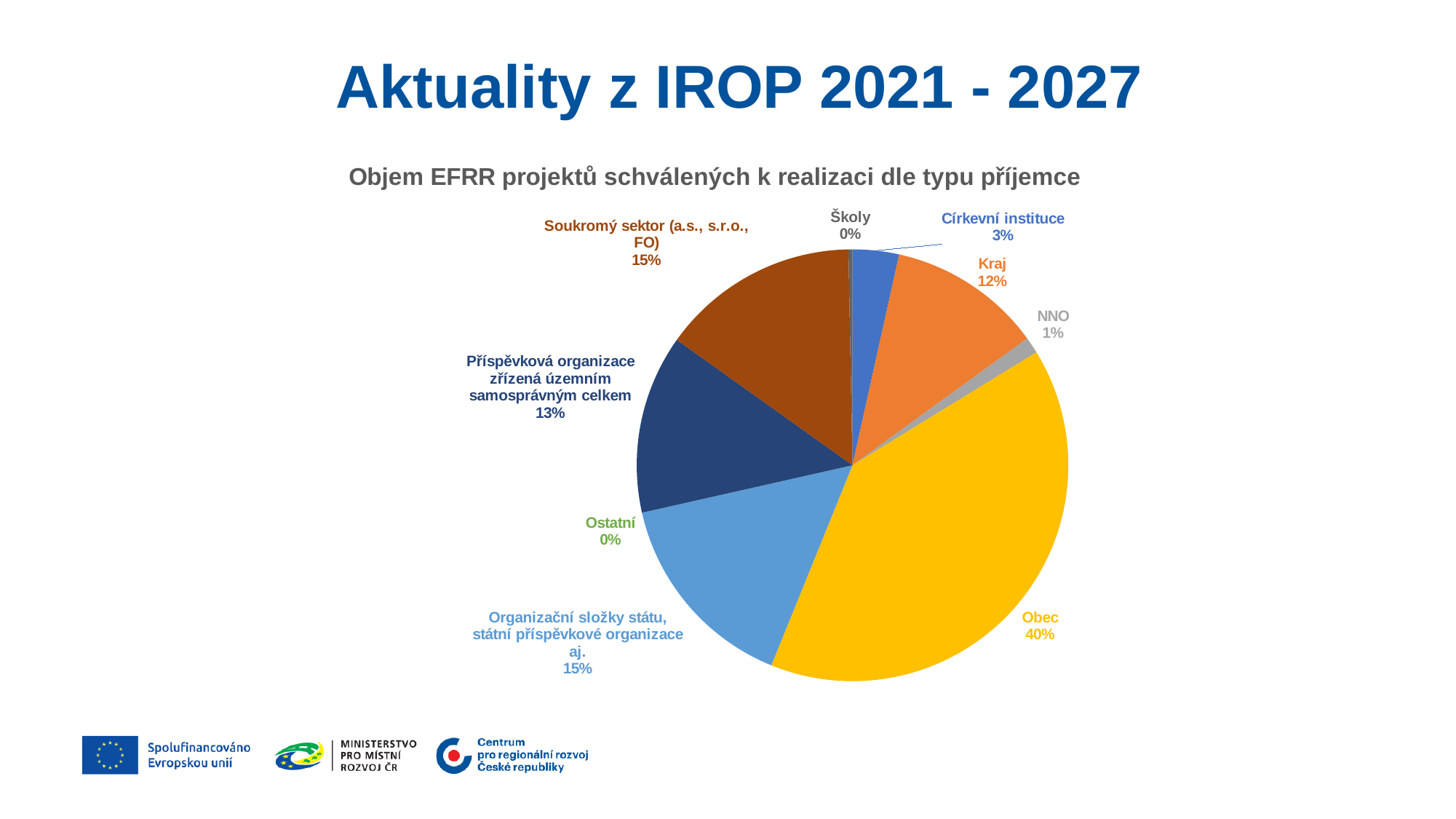
What is the value for Soukromý sektor (a.s., s.r.o., FO)? 15% What share of the pie does Obec account for? 40% How many categories are shown in the pie chart? 9 What type of chart is shown on the slide? pie chart What is the value for Příspěvková organizace zřízená územním samosprávným celkem? 13% Which is larger, the share for Kraj or the share for Příspěvková organizace zřízená územním samosprávným celkem? Příspěvková organizace zřízená územním samosprávným celkem What is the difference between the shares of Obec and Kraj? 28% What is the value for NNO? 1% Which category has the largest share of the pie? Obec What is the title of the chart? Objem EFRR projektů schválených k realizaci dle typu příjemce What is the value for Kraj? 12% What is the value for Církevní instituce? 3%